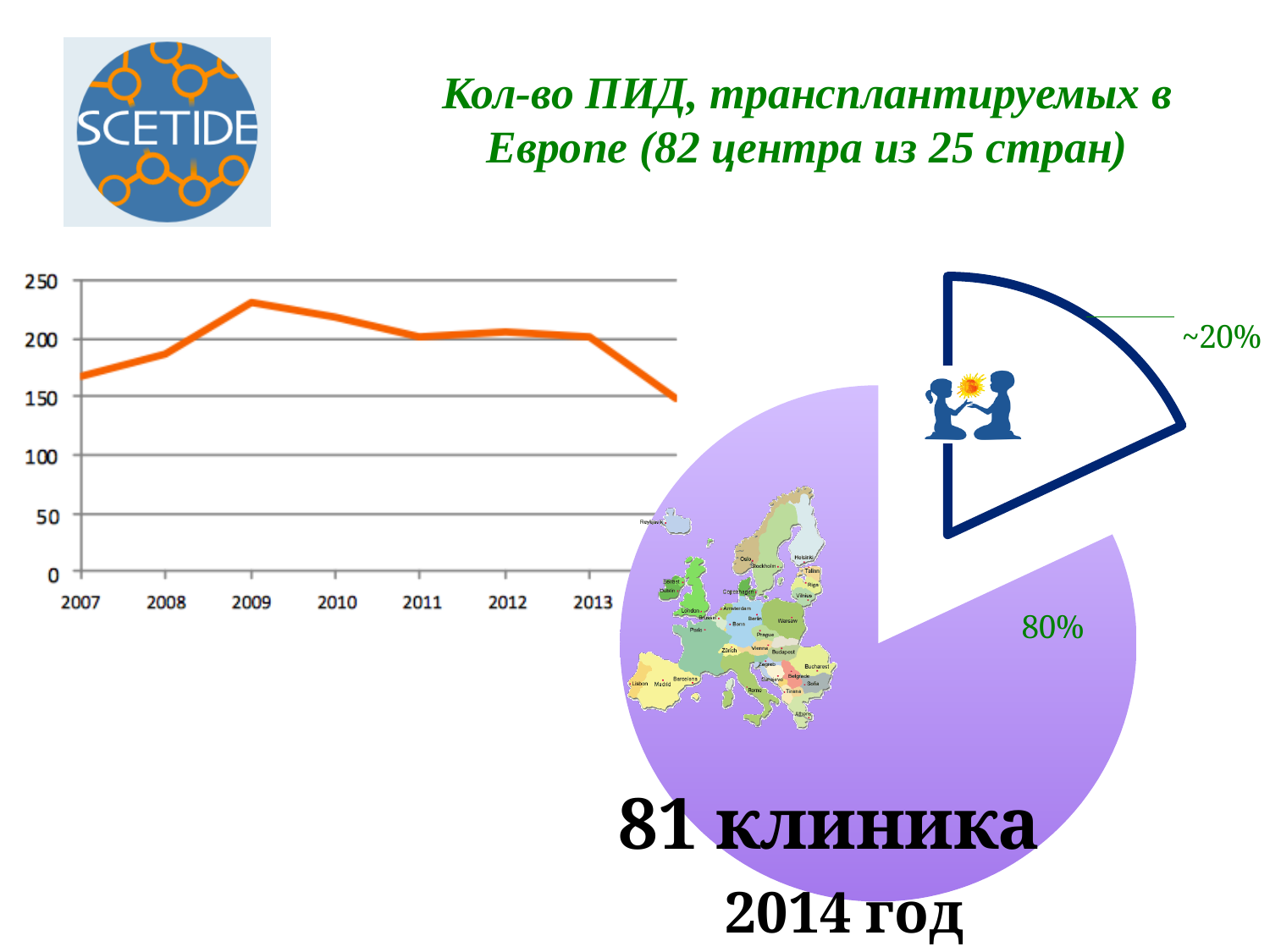
In the line chart on the left, which is larger, the value for 2008 or the value for 2009? 2009 In the line chart on the left, is the value for 2009 greater or less than 200? greater In the line chart on the left, does the value rise or fall from 2007 to 2009? rise In the line chart on the left, how many years are labeled on the x axis? 7 What is the title of the slide above the charts? Кол-во ПИД, трансплантируемых в Европе (82 центра из 25 стран) What kind of chart is shown on the left side of the slide? line chart In the pie chart on the right, what share is shown for the small separated slice? ~20% In the line chart on the left, which labeled year has the lowest value? 2007 In the line chart on the left, which labeled year has the highest value? 2009 In the pie chart on the right, what share is shown for the large purple slice? 80% In the line chart on the left, is the value for 2007 greater or less than 200? less In the line chart on the left, is the value for 2011 greater or less than 150? greater